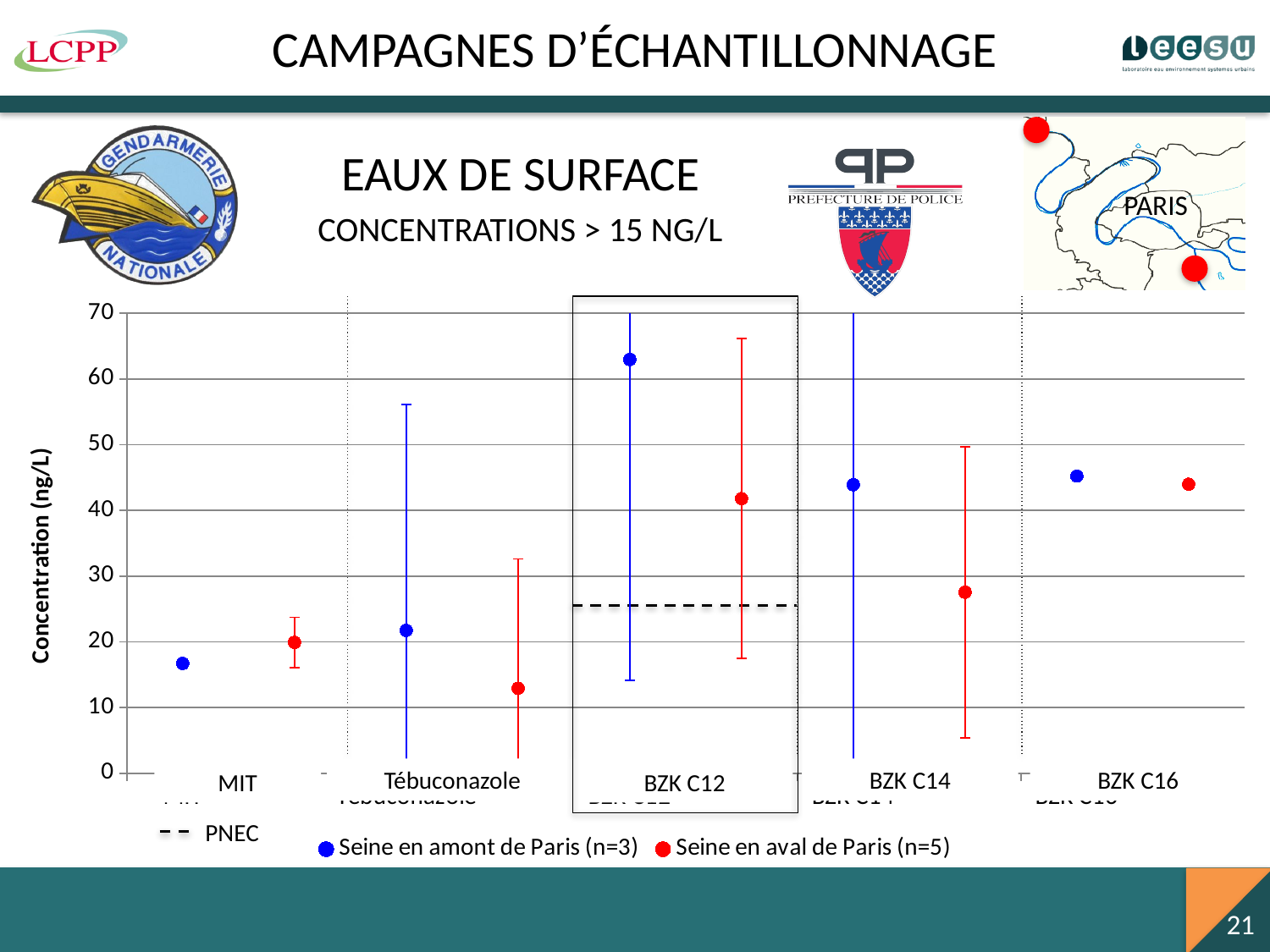
For Tébuconazole, which is larger: the 'Seine en amont de Paris (n=3)' value or the 'Seine en aval de Paris (n=5)' value? Seine en amont de Paris (n=3) How many compounds (categories) are shown on the x axis of the chart? 5 How many entries does the chart legend list? 3 For BZK C12, which is larger: the 'Seine en amont de Paris (n=3)' value or the 'Seine en aval de Paris (n=5)' value? Seine en amont de Paris (n=3) Is the 'Seine en amont de Paris (n=3)' value for BZK C14 greater or less than 40? greater For which compound is the 'Seine en aval de Paris (n=5)' value lowest? Tébuconazole Which category on the x axis is highlighted with a box on the chart? BZK C12 Is the 'Seine en aval de Paris (n=5)' value for Tébuconazole greater or less than 20? less What kind of chart is shown on the slide? Scatter (point) chart with error bars Is the 'Seine en amont de Paris (n=3)' value for BZK C12 greater or less than 60? greater What is the label of the y axis of the chart? Concentration (ng/L) For which compound is the 'Seine en amont de Paris (n=3)' value highest? BZK C12